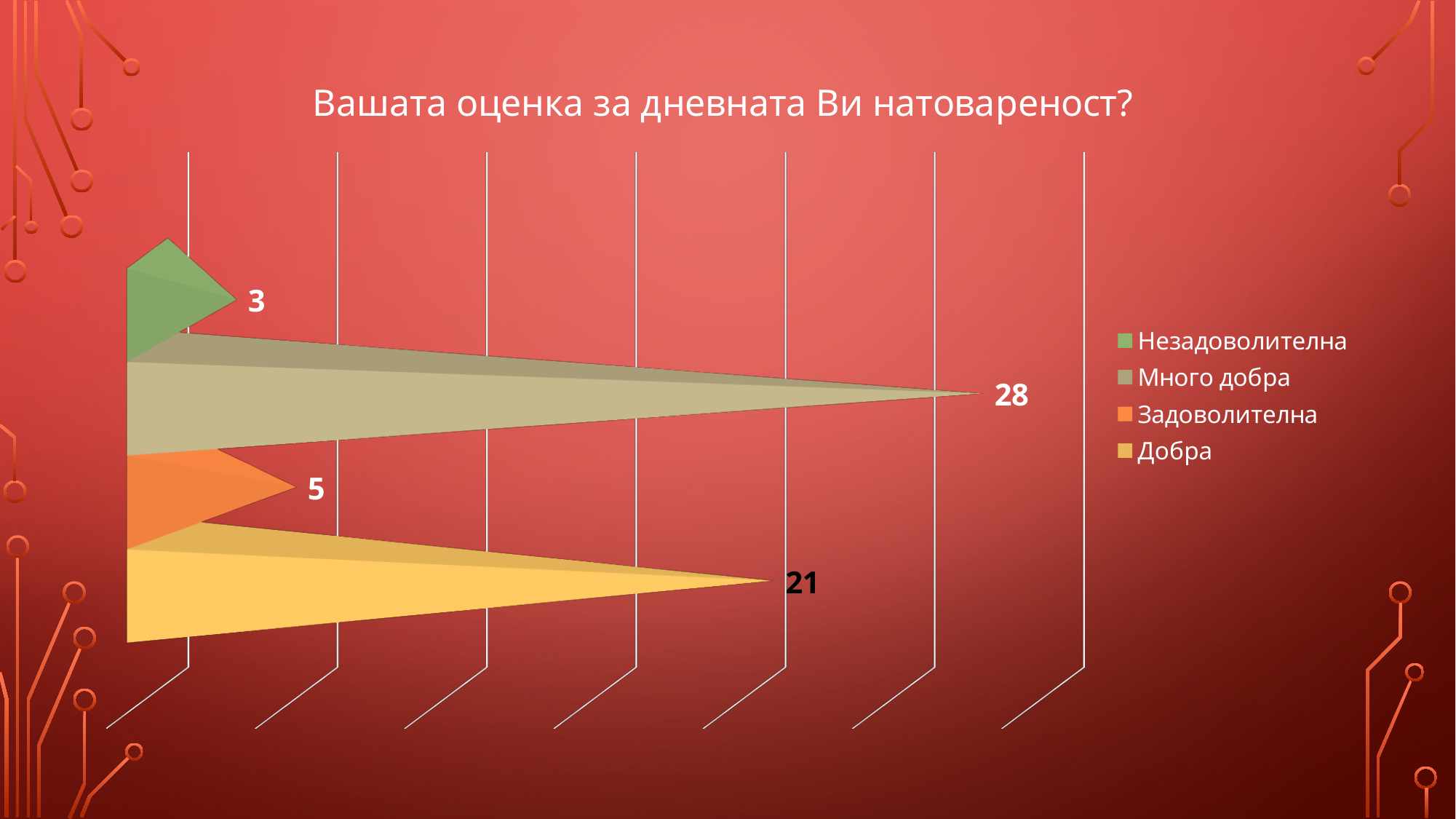
What is the difference between the values for Задоволителна and Незадоволителна? 2 What kind of chart is shown on the slide? Bar chart Which category has the lowest value? Незадоволителна What is the difference between the values for Много добра and Добра? 7 What is the value for Добра? 21 What is the title of the chart? Вашата оценка за дневната Ви натовареност? What is the value for Много добра? 28 What is the value for Незадоволителна? 3 Which is larger, the value for Добра or the value for Задоволителна? Добра Which category has the highest value? Много добра How many categories are shown in the chart? 4 What is the value for Задоволителна? 5